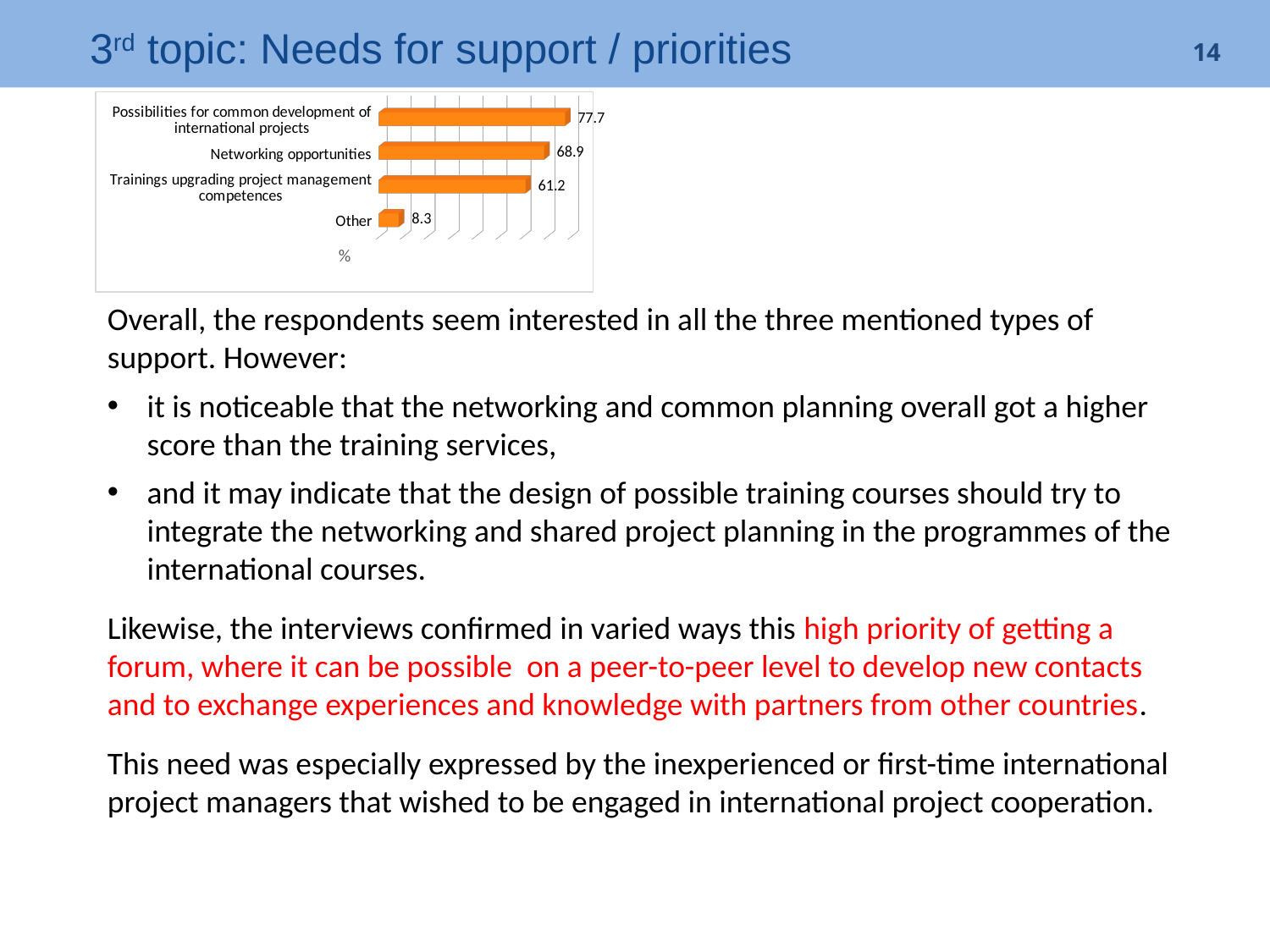
What is the value for Trainings upgrading project management competences? 61.2 What is the value for Networking opportunities? 68.9 What is the value for Other? 8.3 What kind of chart is shown on the slide? Bar chart What unit is indicated on the chart's axis label? % What is the difference between the values for Possibilities for common development of international projects and Networking opportunities? 8.8 How many categories are shown in the chart? 4 What is the difference between the values for Networking opportunities and Trainings upgrading project management competences? 7.7 Which category has the highest value? Possibilities for common development of international projects Which category has the lowest value? Other Which is larger, the value for Networking opportunities or the value for Trainings upgrading project management competences? Networking opportunities What is the value for Possibilities for common development of international projects? 77.7